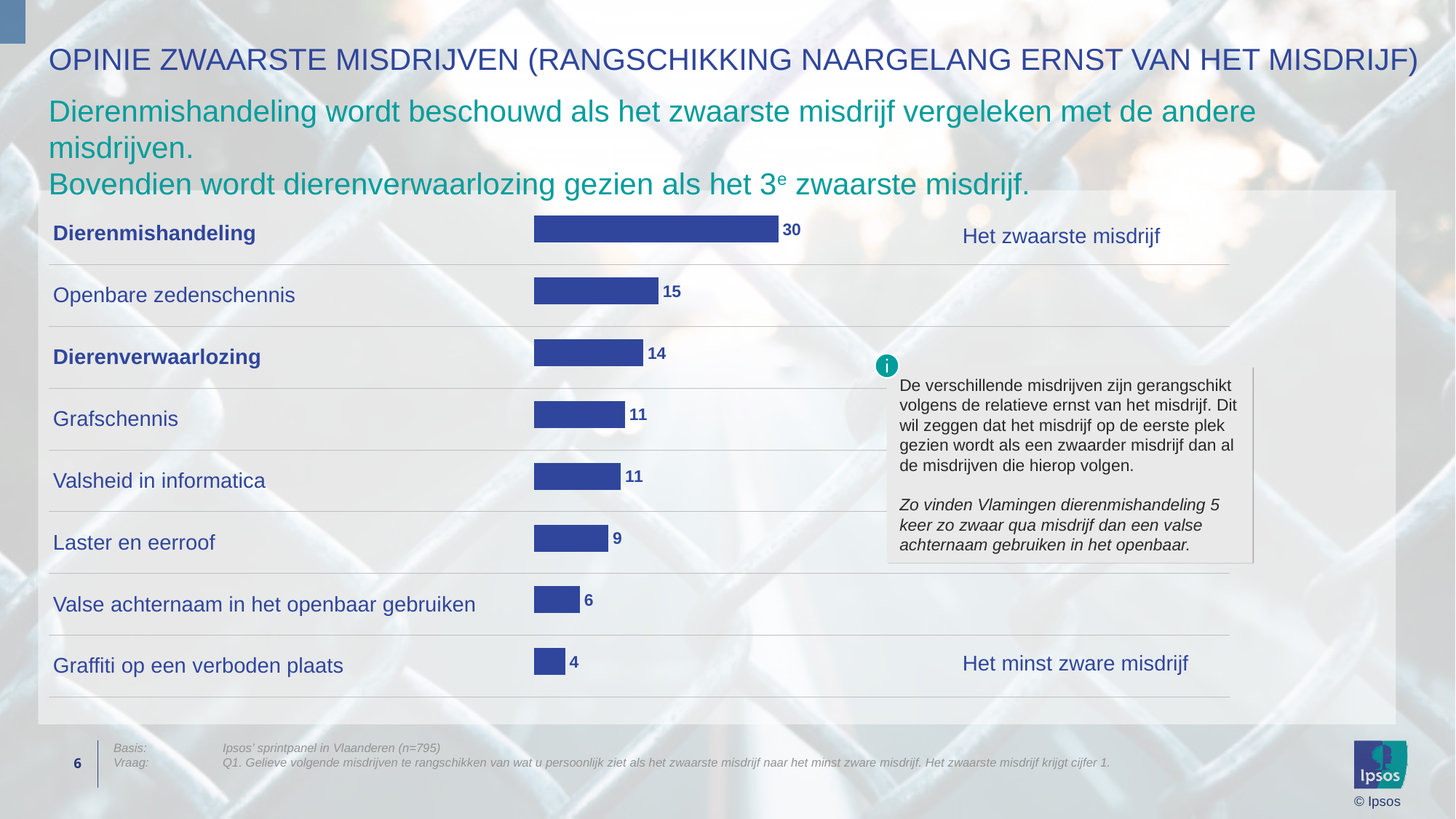
How many categories are shown in the chart? 8 What is the value for Laster en eerroof? 9 What is the difference between the values for Dierenmishandeling and Openbare zedenschennis? 15 What kind of chart is shown on the slide? Bar chart What is the value for Dierenmishandeling? 30 Which is larger, the value for Openbare zedenschennis or the value for Dierenverwaarlozing? Openbare zedenschennis What is the difference between the values for Valse achternaam in het openbaar gebruiken and Graffiti op een verboden plaats? 2 What is the value for Dierenverwaarlozing? 14 What is the value for Graffiti op een verboden plaats? 4 Which category has the highest value? Dierenmishandeling Which category is labelled as 'Het minst zware misdrijf' on the chart? Graffiti op een verboden plaats Which category has the lowest value? Graffiti op een verboden plaats